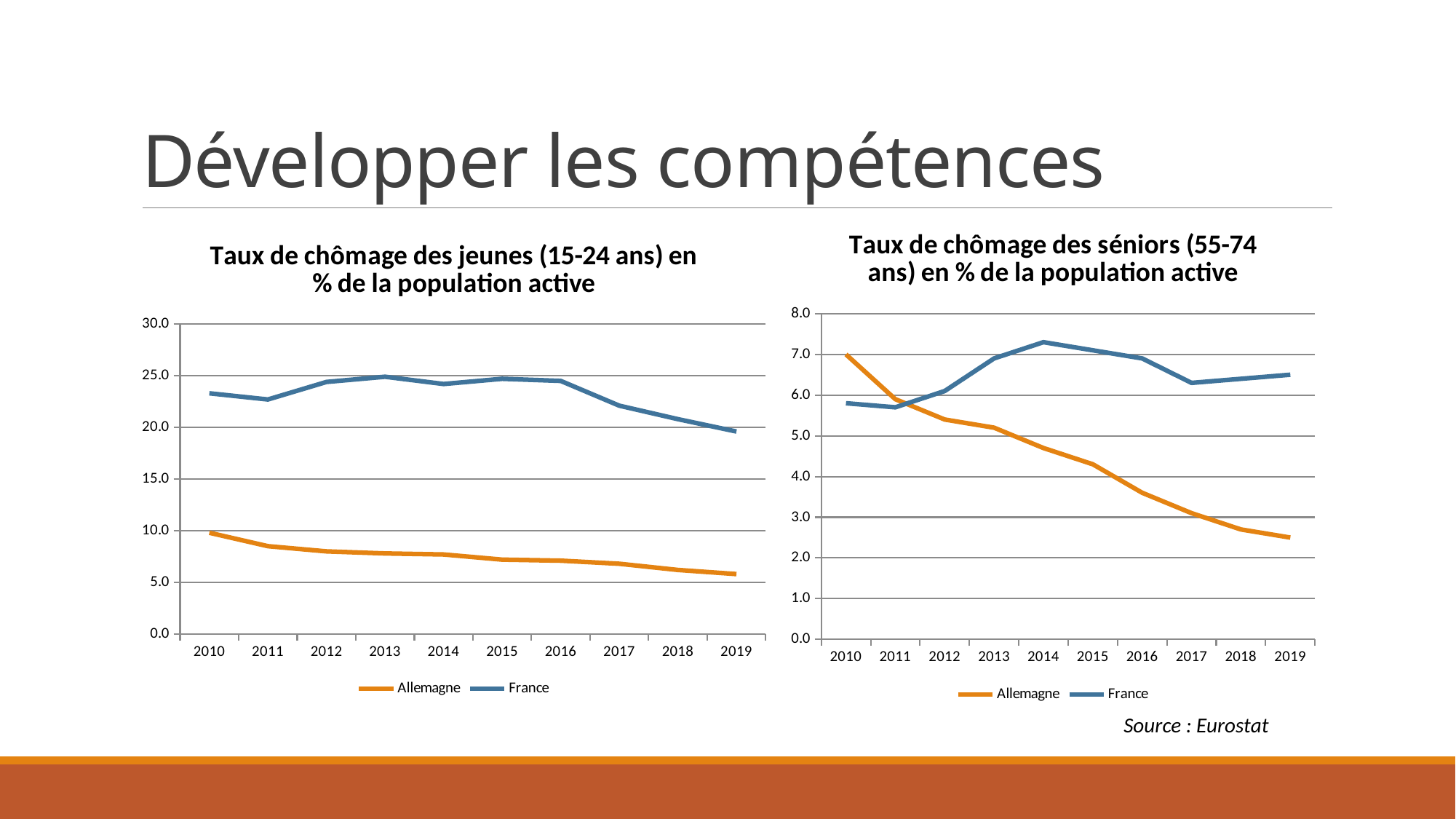
In the right chart, 'Taux de chômage des séniors (55-74 ans)', in which year is the France series highest? 2014 In the right chart, 'Taux de chômage des séniors (55-74 ans)', which series is higher in 2010, Allemagne or France? Allemagne How many series does the legend of the right chart, 'Taux de chômage des séniors (55-74 ans)', list? 2 In the right chart, 'Taux de chômage des séniors (55-74 ans)', does the Allemagne series rise or fall from 2010 to 2019? fall In the left chart, 'Taux de chômage des jeunes (15-24 ans)', is the value for Allemagne in 2019 greater or less than 10.0? less In the left chart, 'Taux de chômage des jeunes (15-24 ans)', in which year is the Allemagne series highest? 2010 In the left chart, 'Taux de chômage des jeunes (15-24 ans)', is the value for France in 2011 greater or less than 20.0? greater In the left chart, 'Taux de chômage des jeunes (15-24 ans)', in which year is the France series lowest? 2019 What kind of chart is the left chart, 'Taux de chômage des jeunes (15-24 ans) en % de la population active'? line chart In the left chart, 'Taux de chômage des jeunes (15-24 ans)', which series is higher in 2015, Allemagne or France? France In the right chart, 'Taux de chômage des séniors (55-74 ans)', is the value for Allemagne in 2019 greater or less than 3.0? less How many years are shown on the x axis of the left chart, 'Taux de chômage des jeunes (15-24 ans)'? 10